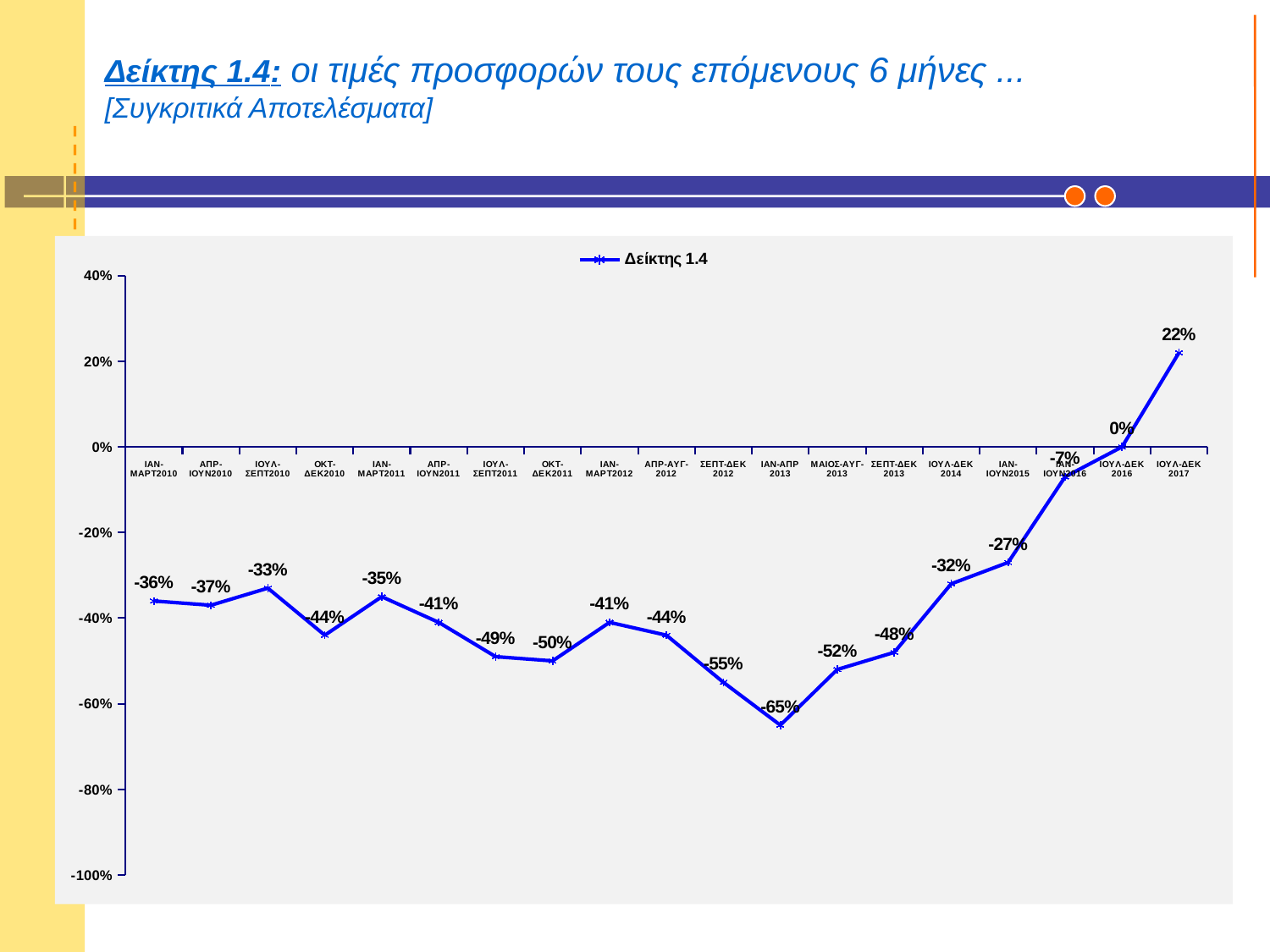
Do the values rise or fall from ΙΑΝ-ΑΠΡ 2013 to ΙΟΥΛ-ΔΕΚ 2017? Rise Which is larger, the value for ΟΚΤ-ΔΕΚ2010 or the value for ΙΑΝ-ΜΑΡΤ2011? ΙΑΝ-ΜΑΡΤ2011 What is the name of the series shown in the legend? Δείκτης 1.4 What is the value of Δείκτης 1.4 for ΣΕΠΤ-ΔΕΚ 2012? -55% What is the difference in percentage points between the value for ΙΟΥΛ-ΔΕΚ 2017 and the value for ΙΑΝ-ΑΠΡ 2013? 87 percentage points Which period has the highest value of Δείκτης 1.4? ΙΟΥΛ-ΔΕΚ 2017 Which period has the lowest value of Δείκτης 1.4? ΙΑΝ-ΑΠΡ 2013 What is the value of Δείκτης 1.4 for ΙΑΝ-ΜΑΡΤ2010? -36% What kind of chart is shown on the slide? Line chart How many data points are plotted on the chart? 19 How many series does the legend list? 1 What is the value of Δείκτης 1.4 for ΙΟΥΛ-ΔΕΚ 2017? 22%